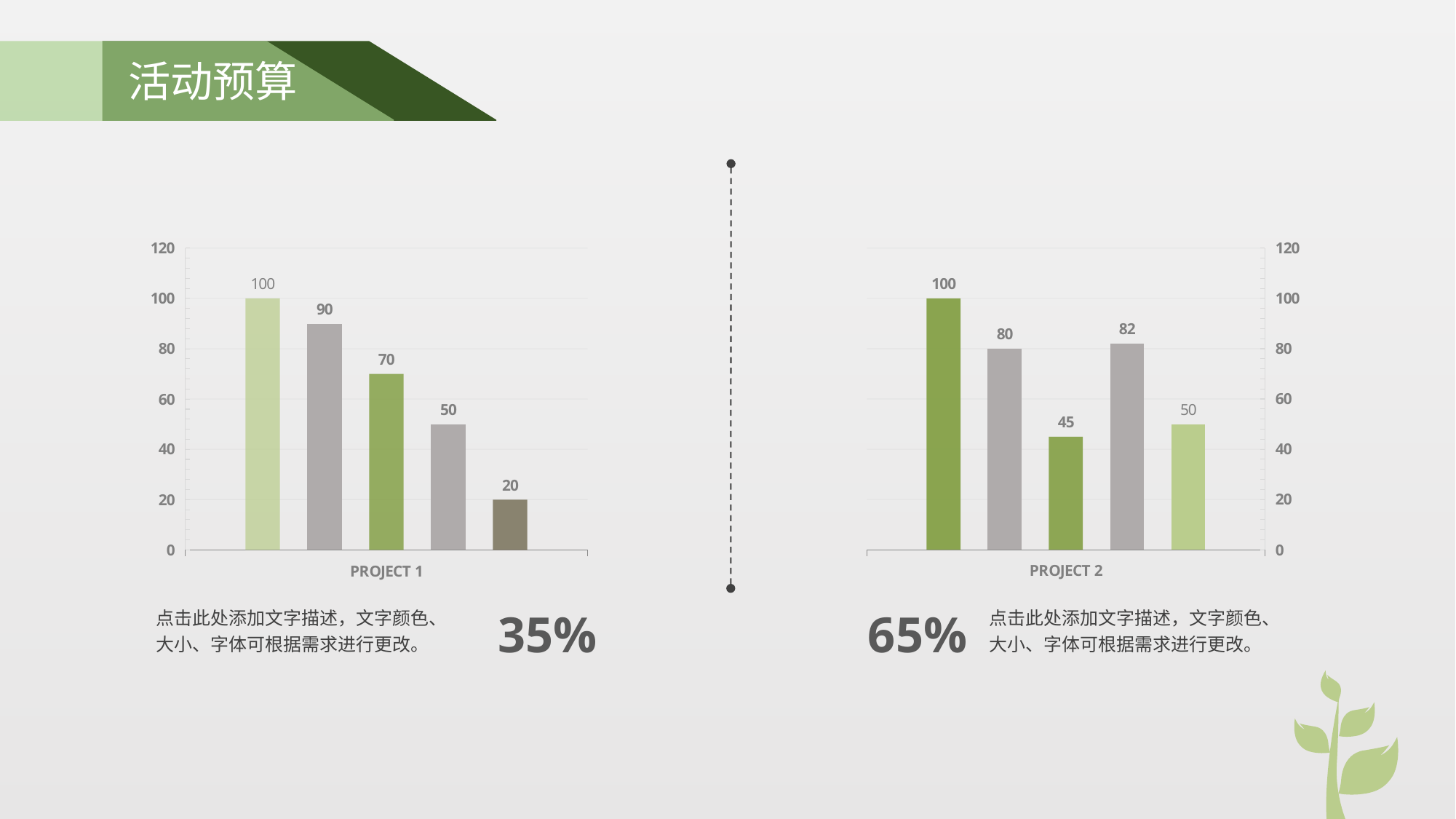
In the left chart (PROJECT 1), what is the value of the first bar? 100 What kind of chart is the left chart labelled PROJECT 1? bar chart In the left chart (PROJECT 1), how many bars are plotted? 5 In the right chart (PROJECT 2), what is the difference between the first bar and the last bar? 50 In the right chart (PROJECT 2), which bar has the lowest value? the third bar (45) In the right chart (PROJECT 2), what is the value of the third bar? 45 In the right chart (PROJECT 2), what is the value of the fourth bar? 82 In the left chart (PROJECT 1), do the bar values rise or fall from left to right? fall What is the highest value shown on the vertical axis of the right chart (PROJECT 2)? 120 In the left chart (PROJECT 1), what is the value of the last bar? 20 In the left chart (PROJECT 1), what is the difference between the second bar and the third bar? 20 In the right chart (PROJECT 2), which is larger, the second bar or the fourth bar? the fourth bar (82)